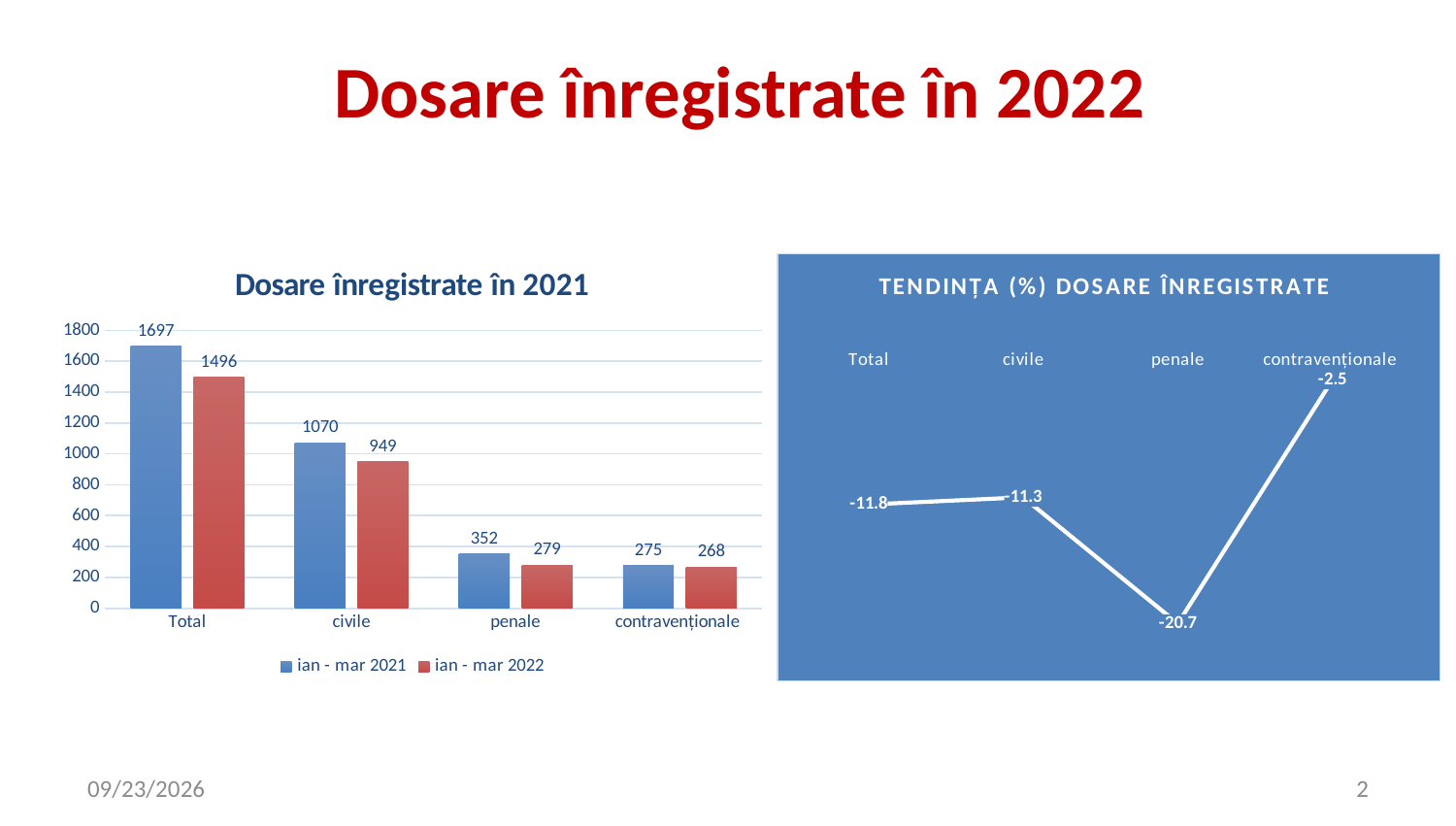
In the chart titled "Dosare înregistrate în 2021", what is the difference between the Total values for ian - mar 2021 and ian - mar 2022? 201 In the chart titled "Dosare înregistrate în 2021", how many categories are shown on the x axis? 4 In the chart titled "Dosare înregistrate în 2021", what colour are the bars for the ian - mar 2022 series? red What kind of chart is the one titled "Dosare înregistrate în 2021"? bar chart What kind of chart is the one titled "TENDINȚA (%) DOSARE ÎNREGISTRATE"? line chart In the chart titled "Dosare înregistrate în 2021", which is larger: the ian - mar 2021 value for civile or the ian - mar 2022 value for civile? ian - mar 2021 In the chart titled "Dosare înregistrate în 2021", what is the value for civile in the ian - mar 2022 series? 949 In the chart titled "Dosare înregistrate în 2021", which category has the lowest value in the ian - mar 2022 series? contravenționale In the chart titled "TENDINȚA (%) DOSARE ÎNREGISTRATE", which category has the highest value? contravenționale In the chart titled "Dosare înregistrate în 2021", how many series does the legend list? 2 In the chart titled "TENDINȚA (%) DOSARE ÎNREGISTRATE", what is the value for penale? -20.7 In the chart titled "Dosare înregistrate în 2021", what is the value for penale in the ian - mar 2021 series? 352